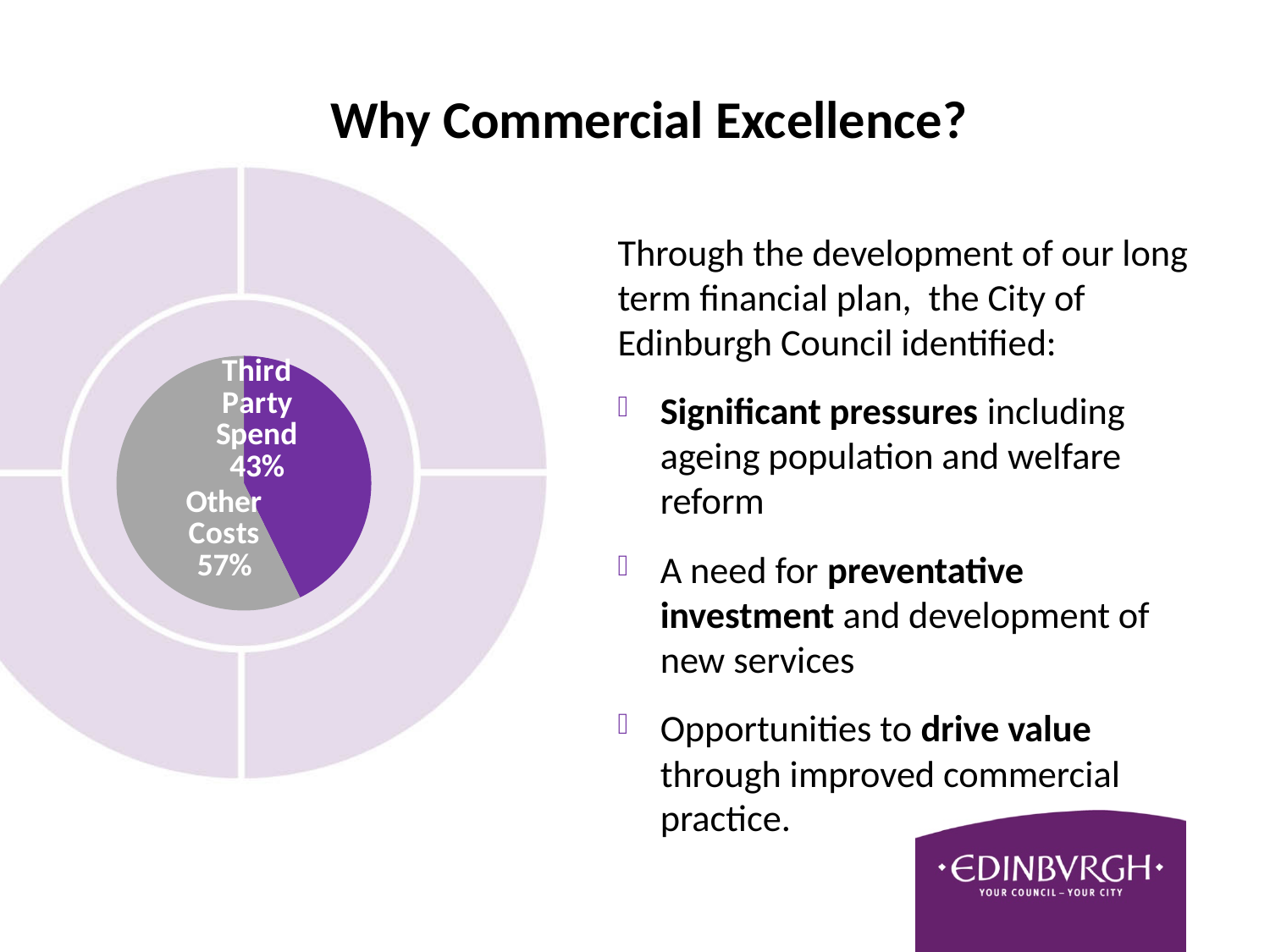
How many slices does the pie chart have? 2 Is the share for Third Party Spend greater or less than 50%? less Which is larger, Third Party Spend or Other Costs? Other Costs What colour is the Other Costs slice? grey What kind of chart is shown on the slide? pie chart What share of the pie is Other Costs? 57% What colour is the Third Party Spend slice? purple Which slice of the pie is the smallest? Third Party Spend Which slice of the pie is the largest? Other Costs What is the difference in percentage points between Other Costs and Third Party Spend? 14 What share of the pie is Third Party Spend? 43%